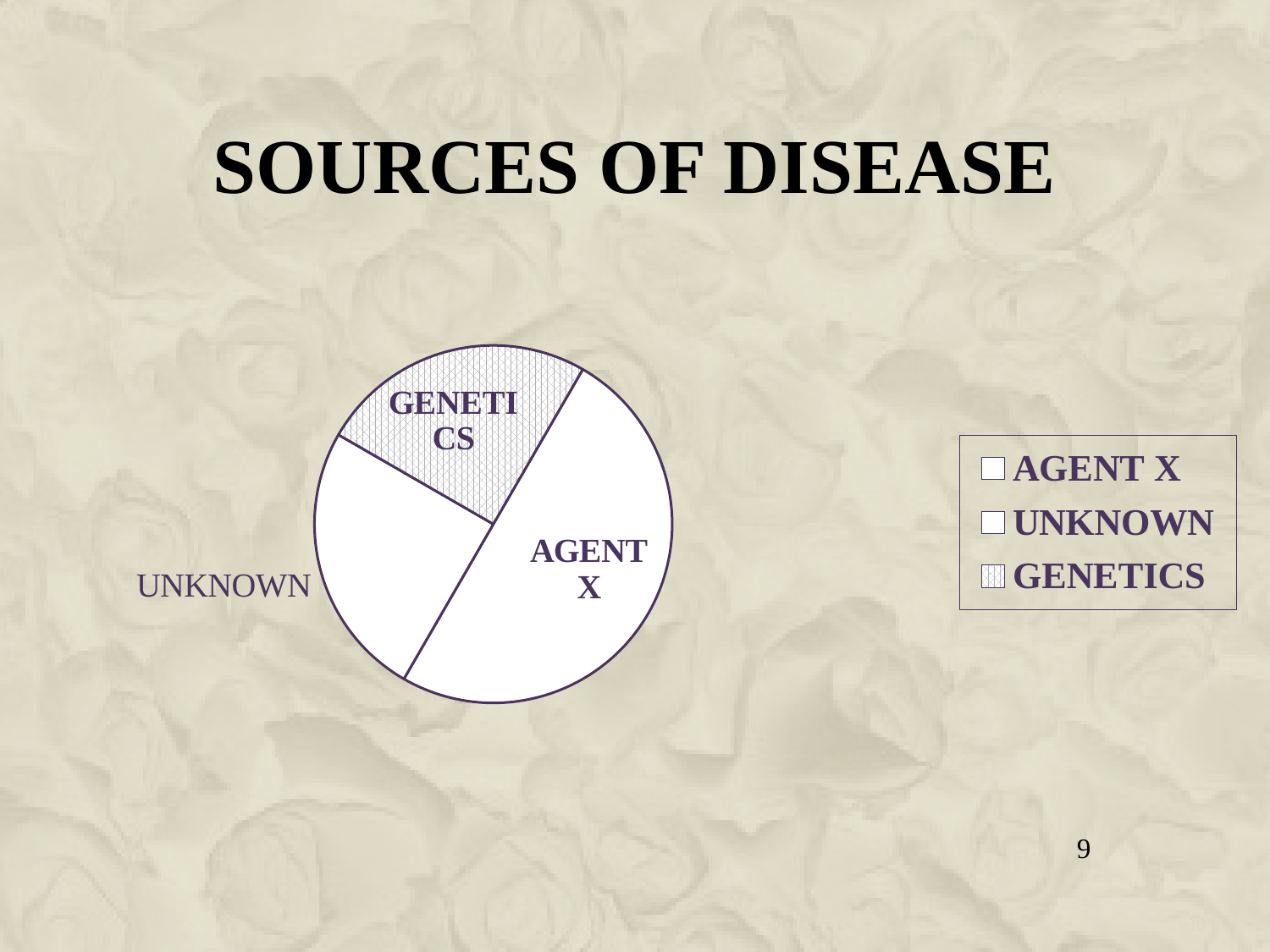
Which slice is larger, AGENT X or UNKNOWN? AGENT X Which source of disease has the largest slice of the pie? AGENT X How many entries does the legend list? 3 Which slice of the pie chart is filled with a cross-hatch pattern? GENETICS What kind of chart is shown on the slide? Pie chart How many slices does the pie chart have? 3 What is the title of the slide containing the pie chart? SOURCES OF DISEASE Which slice is smaller, AGENT X or GENETICS? GENETICS